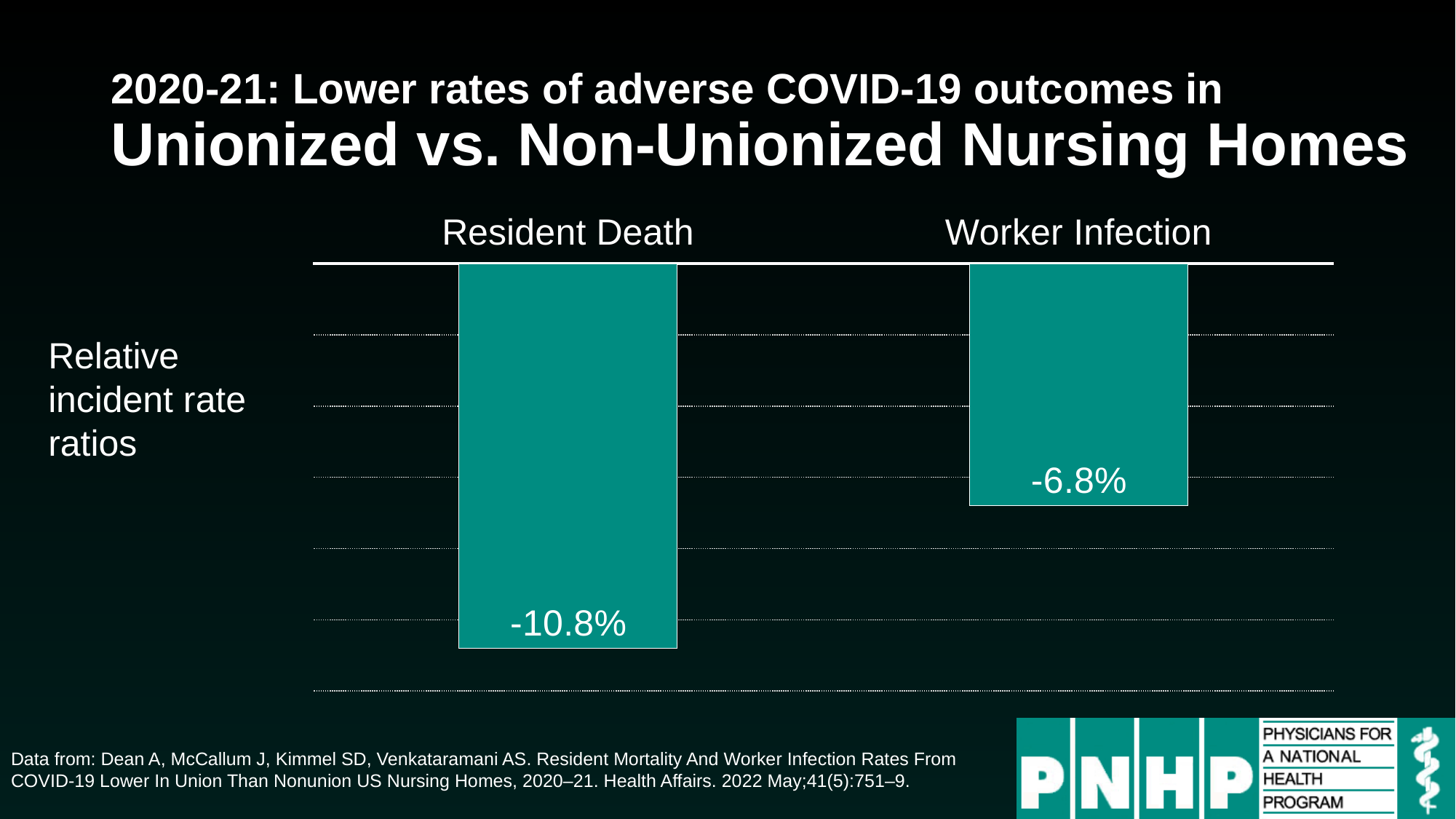
What is the difference in percentage points between the Resident Death value and the Worker Infection value? 4 percentage points Which category shows the smaller reduction (the shorter bar)? Worker Infection What is the value shown for Worker Infection? -6.8% Which category shows the larger reduction (the bar extending furthest below the baseline)? Resident Death What kind of chart is shown on the slide? bar chart Is the reduction for Resident Death larger or smaller than the reduction for Worker Infection? larger How many categories are plotted in the chart? 2 What label appears to the left of the chart describing the plotted measure? Relative incident rate ratios What is the value shown for Resident Death? -10.8% Do the bars extend above or below the baseline? below